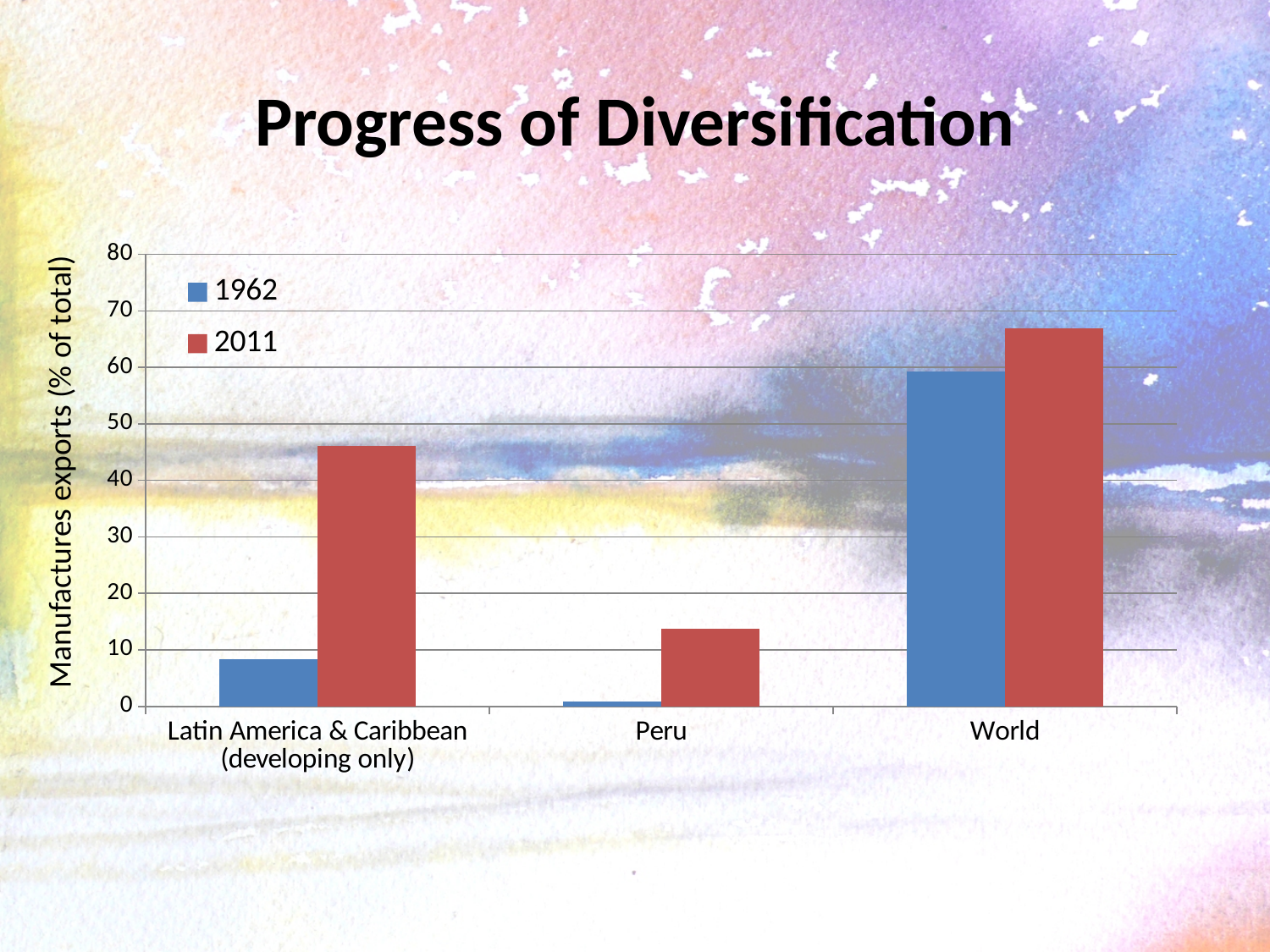
What is the title of the chart? Progress of Diversification Is the 1962 value for Peru greater or less than 10? less What kind of chart is shown on the slide? bar chart Is the 2011 value for Latin America & Caribbean (developing only) greater or less than 40? greater Which category has the highest value for 2011? World How many categories are shown on the x axis? 3 Which category has the lowest value for 1962? Peru Which is larger: the 2011 value for Latin America & Caribbean (developing only) or the 1962 value for World? 1962 value for World Is the 2011 value for Peru greater or less than 20? less What is the label on the y axis? Manufactures exports (% of total) How many series does the legend list? 2